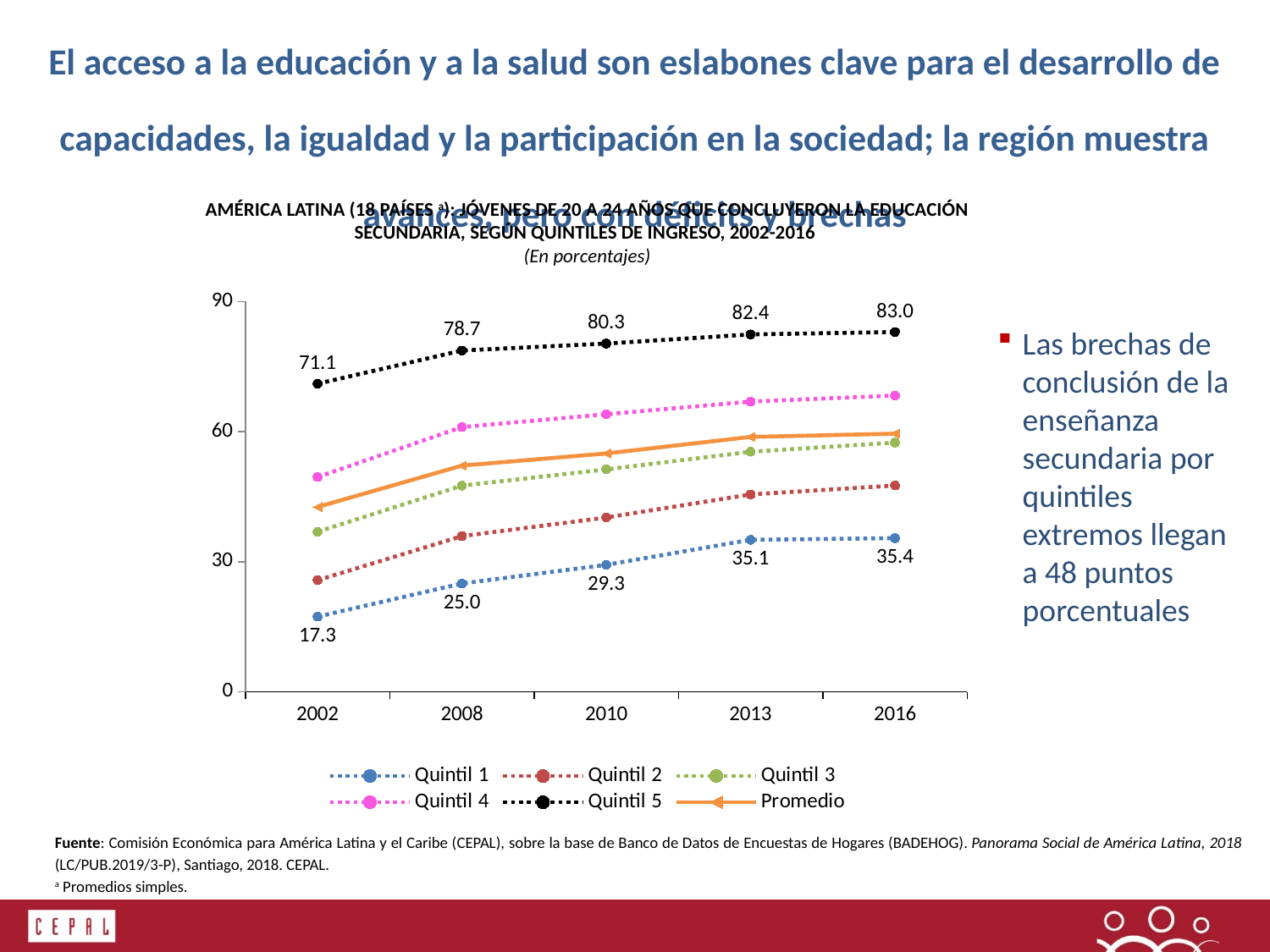
In which year is the value for Quintil 1 lowest? 2002 What is the value for Quintil 1 in 2010? 29.3 What type of chart is shown on the slide? line chart What is the difference between Quintil 5 and Quintil 1 in 2016? 47.6 How many years are shown on the x axis? 5 What is the value for Quintil 5 in 2013? 82.4 How many series does the legend list? 6 Which series has the highest values across all years? Quintil 5 Does the value for Quintil 5 rise or fall from 2002 to 2016? rise What is the value for Quintil 5 in 2002? 71.1 What is the value for Quintil 1 in 2016? 35.4